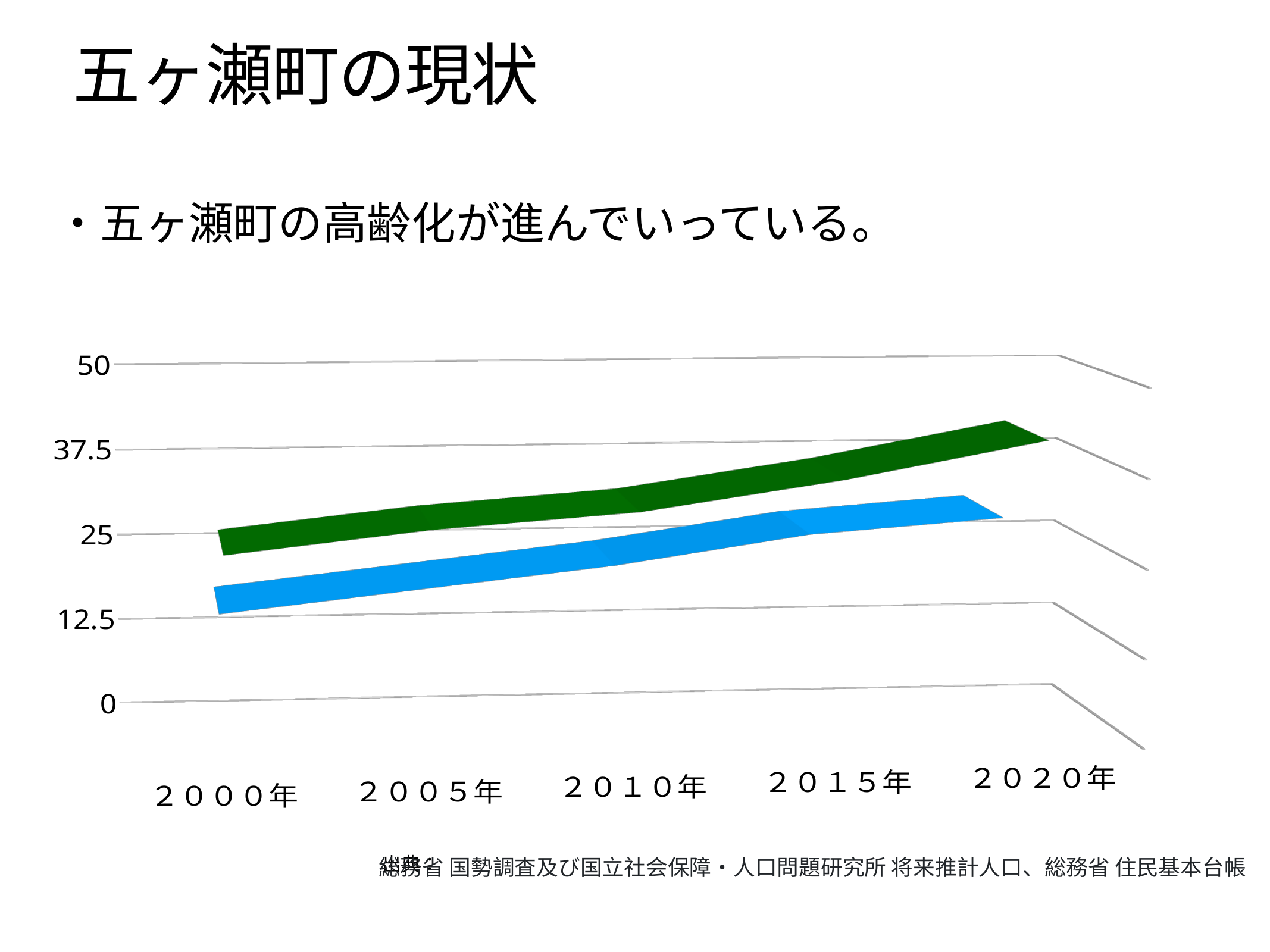
Do the values of the blue line rise or fall from 2000年 to 2020年? rise Is the value of the blue line at 2010年 greater or less than 25? less What is the highest value shown on the chart's vertical axis? 50 What kind of chart is shown on the slide? line chart How many lines (series) are plotted on the chart? 2 Is the value of the green line at 2010年 greater or less than 25? greater At 2010年, which line has the larger value, the green line or the blue line? green line In which year is the blue line at its lowest value? 2000年 How many years are shown on the x axis of the chart? 5 Is the value of the blue line at 2000年 greater or less than 12.5? greater In which year is the green line at its highest value? 2020年 Do the values of the green line rise or fall from 2000年 to 2020年? rise